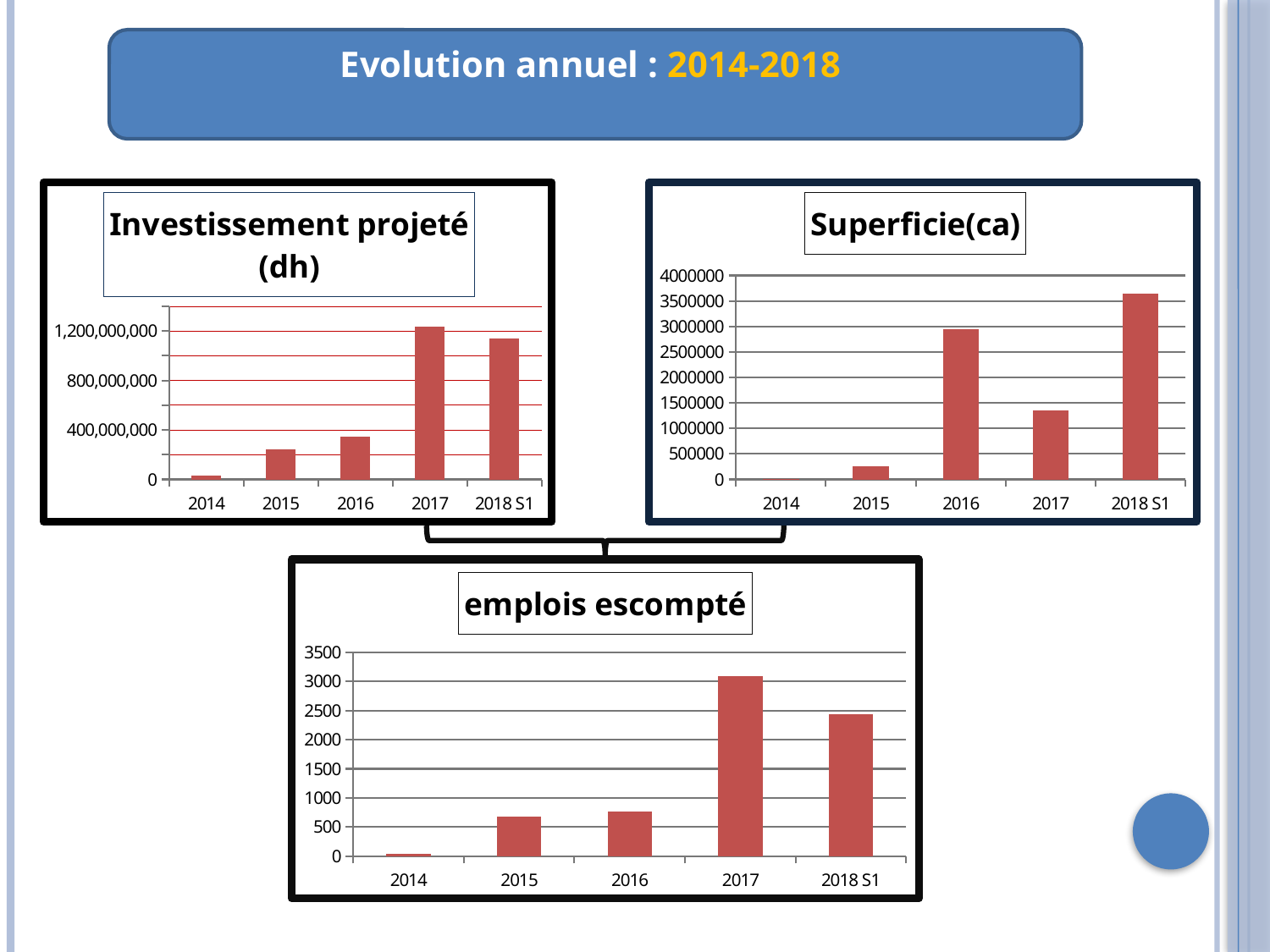
In the 'Superficie(ca)' chart, which year has the lowest value? 2014 In the 'Superficie(ca)' chart, which is larger, the value for 2016 or the value for 2017? 2016 In the 'emplois escompté' chart, which year has the highest value? 2017 In the 'Superficie(ca)' chart, which year has the highest value? 2018 S1 In the 'emplois escompté' chart, is the value for 2017 greater or less than 3000? greater In the 'Investissement projeté (dh)' chart, which year has the lowest projected investment? 2014 In the 'emplois escompté' chart, how many years are shown on the x axis? 5 In the 'Investissement projeté (dh)' chart, is the value for 2017 greater or less than 800,000,000? greater In the 'Investissement projeté (dh)' chart, which year has the highest projected investment? 2017 What kind of chart is the 'emplois escompté' chart? bar chart In the 'Superficie(ca)' chart, is the value for 2016 greater or less than 2500000? greater